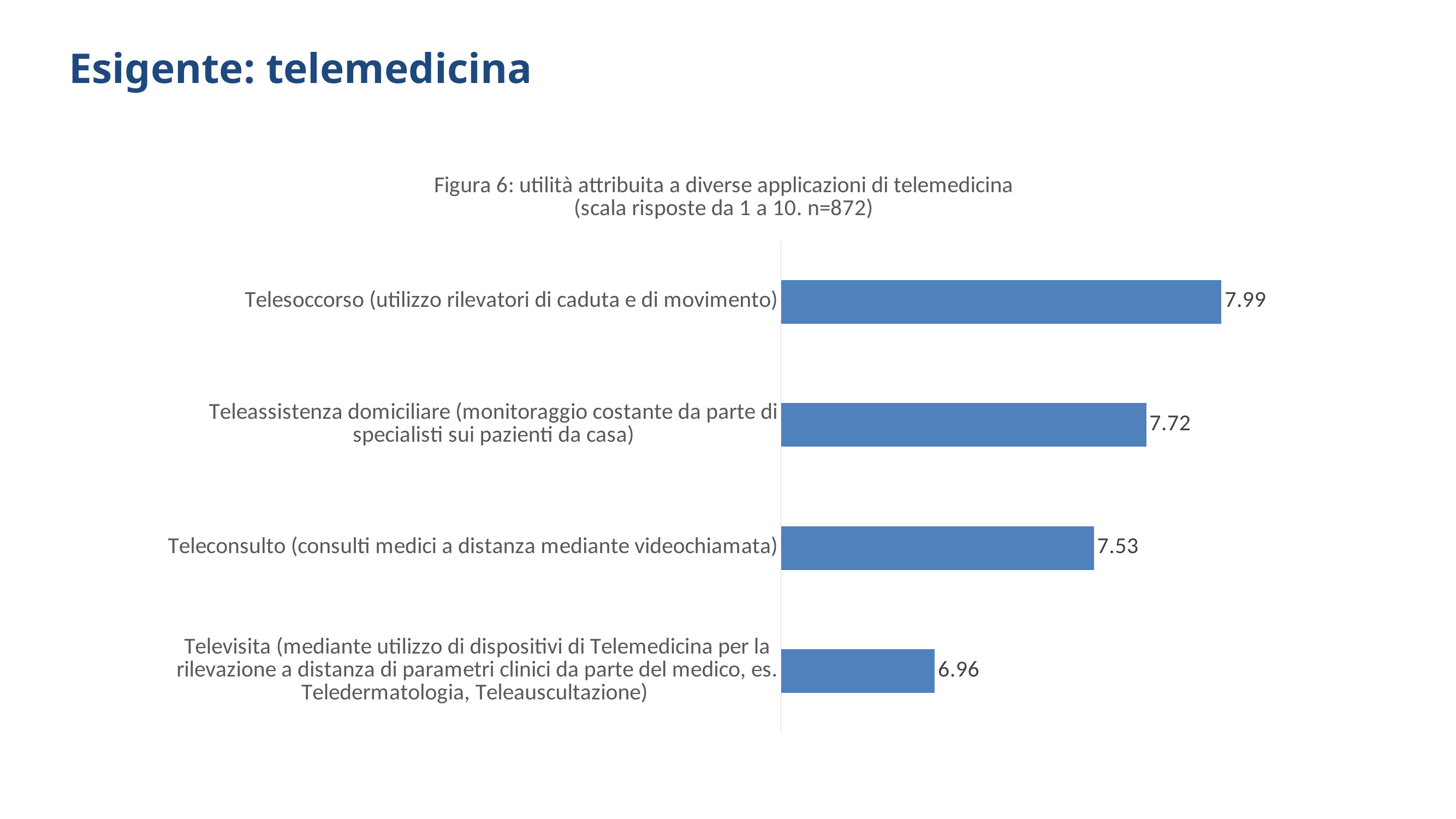
What is the difference between the values for Teleassistenza domiciliare and Teleconsulto? 0.19 What is the value for Televisita? 6.96 What is the sample size (n) stated in the chart title? 872 Which telemedicine application has the highest value? Telesoccorso What is the value for Teleconsulto (consulti medici a distanza mediante videochiamata)? 7.53 What is the value for Telesoccorso (utilizzo rilevatori di caduta e di movimento)? 7.99 What kind of chart is shown on the slide? Bar chart How many telemedicine applications are shown in the chart? 4 Which has a larger value, Teleconsulto or Televisita? Teleconsulto What is the difference between the values for Telesoccorso and Televisita? 1.03 What is the value for Teleassistenza domiciliare (monitoraggio costante da parte di specialisti sui pazienti da casa)? 7.72 Which telemedicine application has the lowest value? Televisita